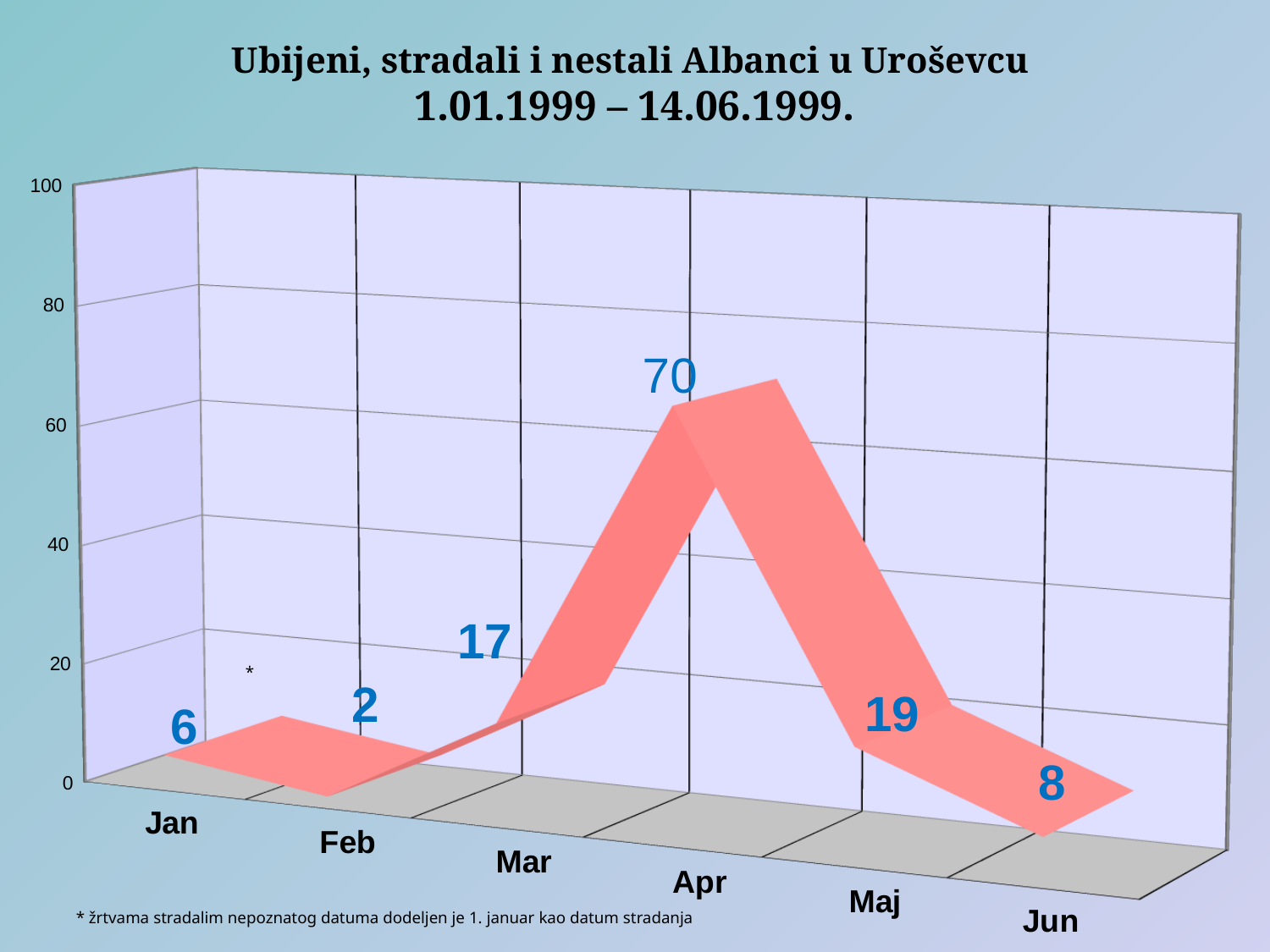
What is the value for Jan? 6 How many months are shown on the x axis? 6 What is the value for Feb? 2 Which month has the highest value? Apr What is the difference between the values for Apr and Maj? 51 Which month has the lowest value? Feb What is the value for Maj? 19 Is the value for Apr greater or less than 60? greater What is the title of the chart? Ubijeni, stradali i nestali Albanci u Uroševcu 1.01.1999 – 14.06.1999. What is the value for Apr? 70 Which is larger, the value for Mar or the value for Jun? Mar What kind of chart is this? 3D line chart